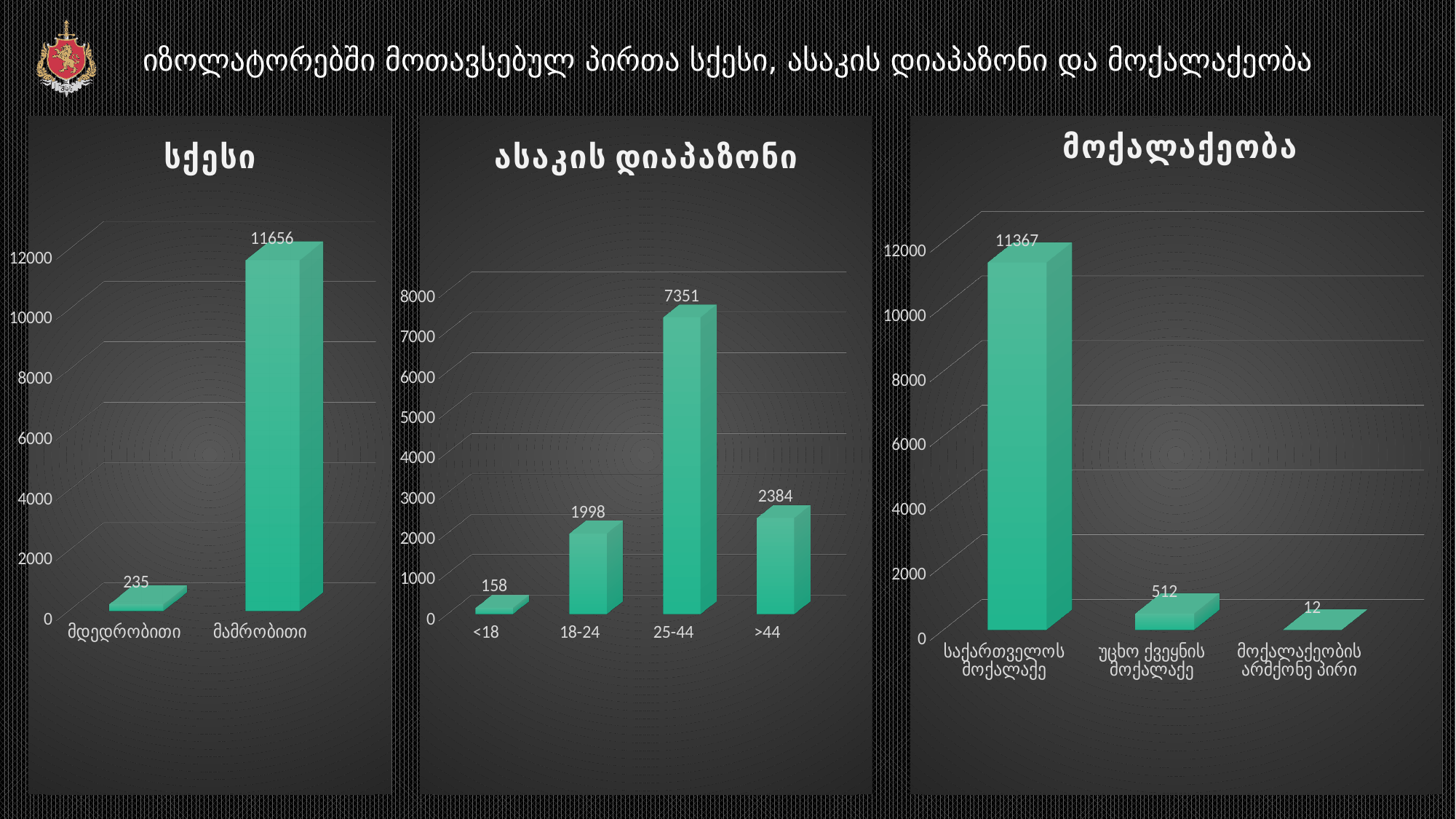
In the middle chart titled "ასაკის დიაპაზონი", which category has the highest value? 25-44 In the right chart titled "მოქალაქეობა", what is the value for "უცხო ქვეყნის მოქალაქე"? 512 In the middle chart titled "ასაკის დიაპაზონი", which is larger: the value for "18-24" or the value for ">44"? >44 In the left chart titled "სქესი", what is the value for "მდედრობითი"? 235 In the middle chart titled "ასაკის დიაპაზონი", what is the value for the "25-44" category? 7351 In the middle chart titled "ასაკის დიაპაზონი", which category has the lowest value? <18 In the middle chart titled "ასაკის დიაპაზონი", how many categories are shown on the x axis? 4 In the middle chart titled "ასაკის დიაპაზონი", what is the difference between the values for ">44" and "18-24"? 386 In the left chart titled "სქესი", what is the value for "მამრობითი"? 11656 In the right chart titled "მოქალაქეობა", what is the value for "მოქალაქეობის არმქონე პირი"? 12 In the left chart titled "სქესი", what is the difference between the values for "მამრობითი" and "მდედრობითი"? 11421 What kind of chart is the right chart titled "მოქალაქეობა"? Bar chart